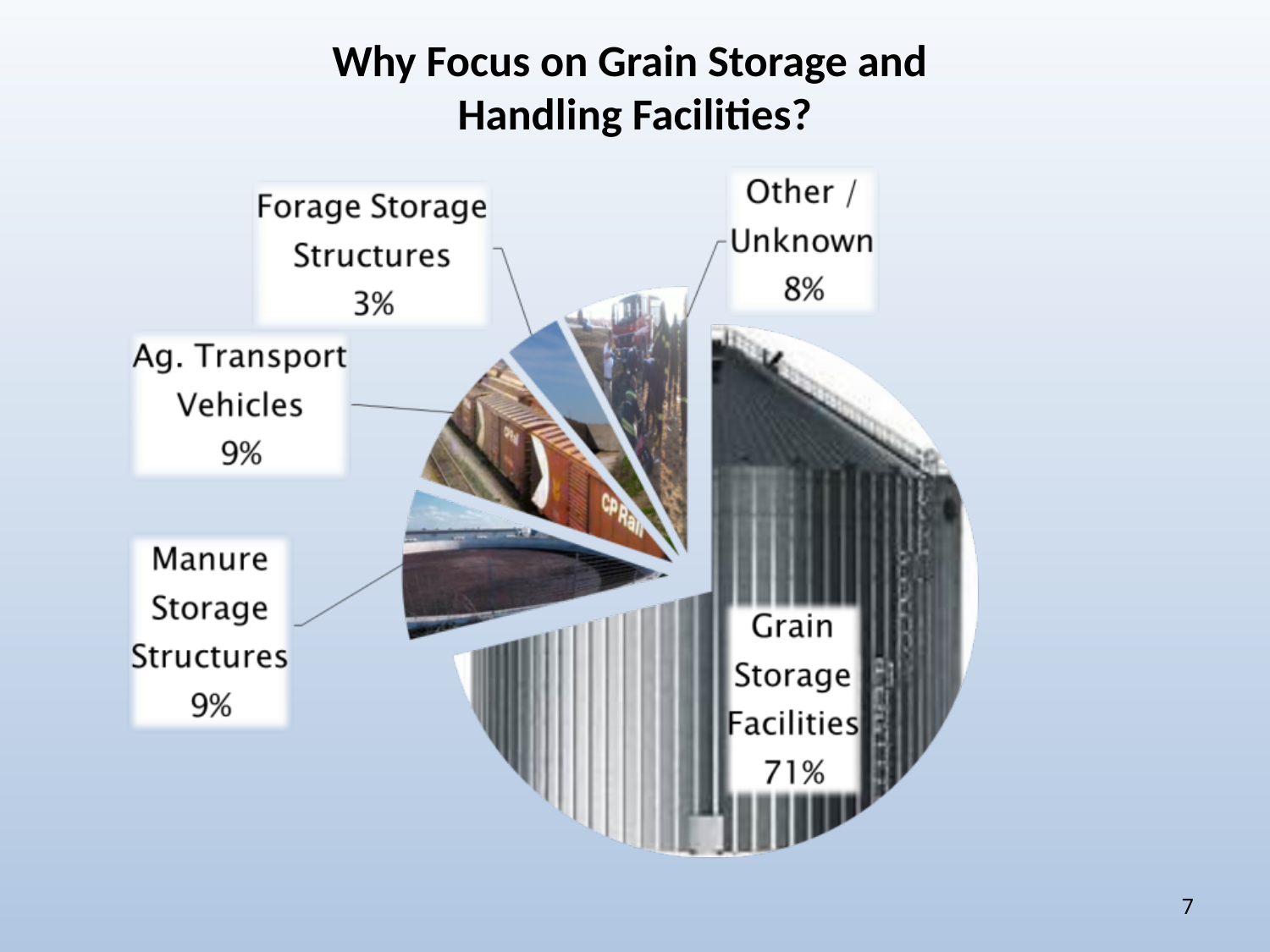
What is the value for Manure Storage Structures? 9% What is the title of the slide containing the pie chart? Why Focus on Grain Storage and Handling Facilities? What is the value for Other / Unknown? 8% Which category has the largest slice? Grain Storage Facilities What is the difference between Grain Storage Facilities and Other / Unknown? 63% What share of the pie is Grain Storage Facilities? 71% What is the value for Forage Storage Structures? 3% How many slices does the pie chart have? 5 Which is larger, Other / Unknown or Forage Storage Structures? Other / Unknown Which category has the smallest slice? Forage Storage Structures What is the value for Ag. Transport Vehicles? 9% What kind of chart is shown on the slide? Pie chart